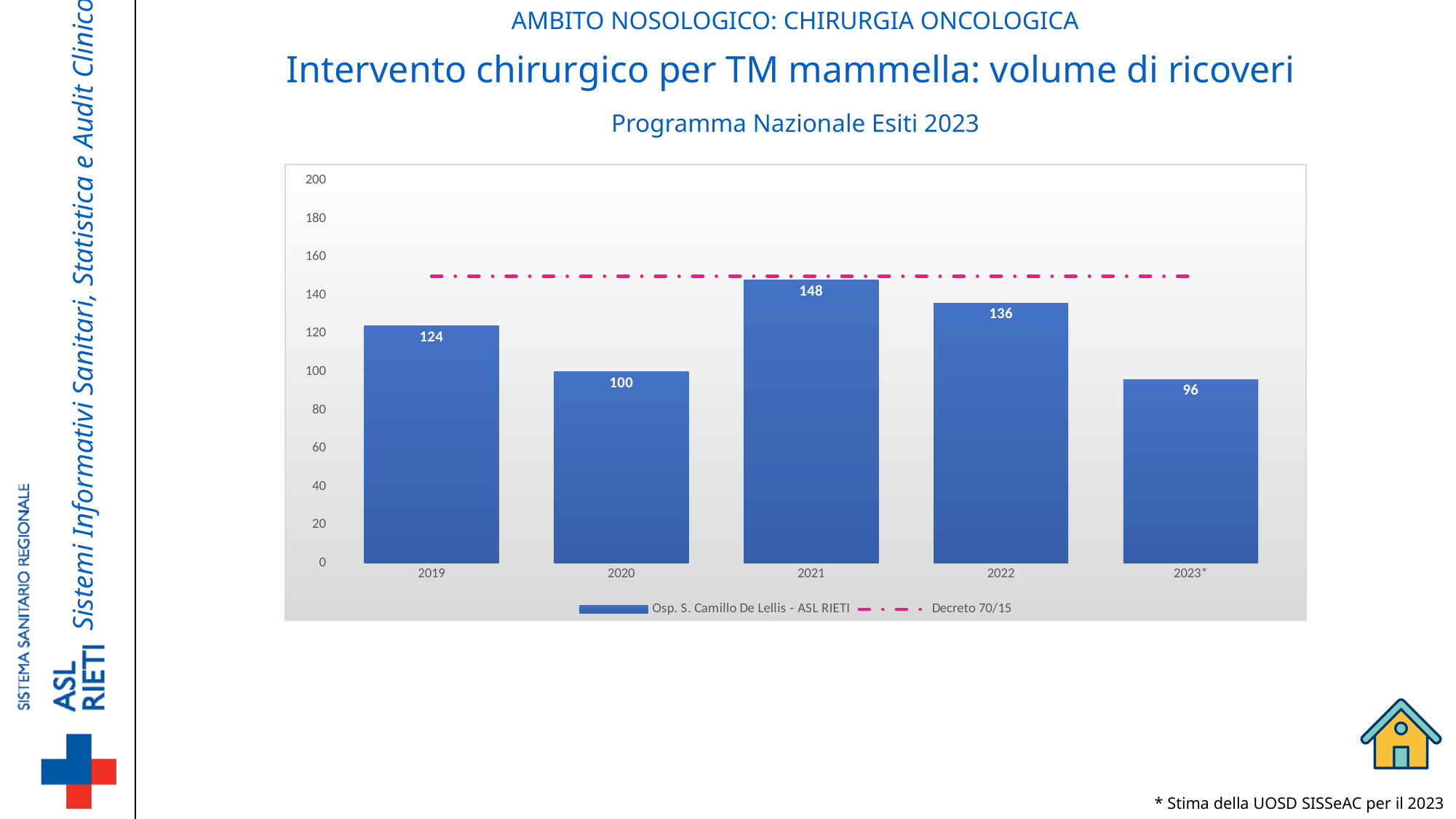
How many years are shown on the x axis? 5 How many entries does the legend list? 2 Which year has the lowest value? 2023* What is the value for 2019? 124 What is the label of the dashed line in the legend? Decreto 70/15 What is the value for 2021? 148 What is the difference between the values for 2021 and 2022? 12 What is the value for 2023*? 96 Which year has the highest value? 2021 Is the value for 2022 greater or less than 120? greater What kind of chart is shown? bar chart Which is larger, the value for 2020 or the value for 2022? 2022